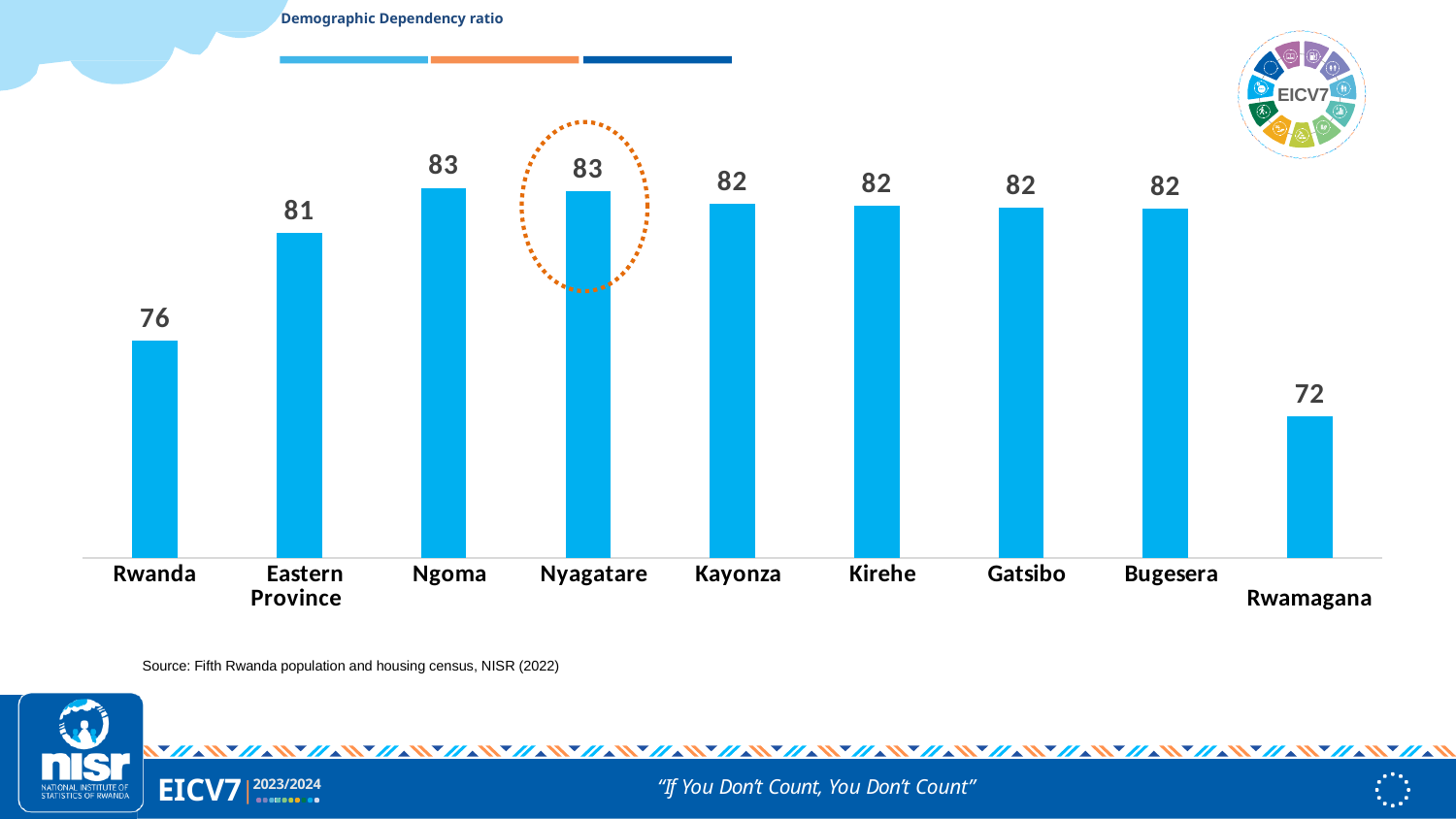
Which category on the chart is highlighted with a dashed orange circle? Nyagatare What is the difference between the demographic dependency ratio of Eastern Province and Rwanda? 5 Which category has the lowest demographic dependency ratio? Rwamagana What is the demographic dependency ratio for Eastern Province? 81 How many categories are shown on the chart? 9 What is the demographic dependency ratio for Rwanda? 76 What is the demographic dependency ratio for Nyagatare? 83 What kind of chart is shown on the slide? Bar chart What is the difference between the demographic dependency ratio of Ngoma and Rwamagana? 11 What is the demographic dependency ratio for Rwamagana? 72 Which has a higher demographic dependency ratio, Rwamagana or Eastern Province? Eastern Province Which has a higher demographic dependency ratio, Rwanda or Kayonza? Kayonza